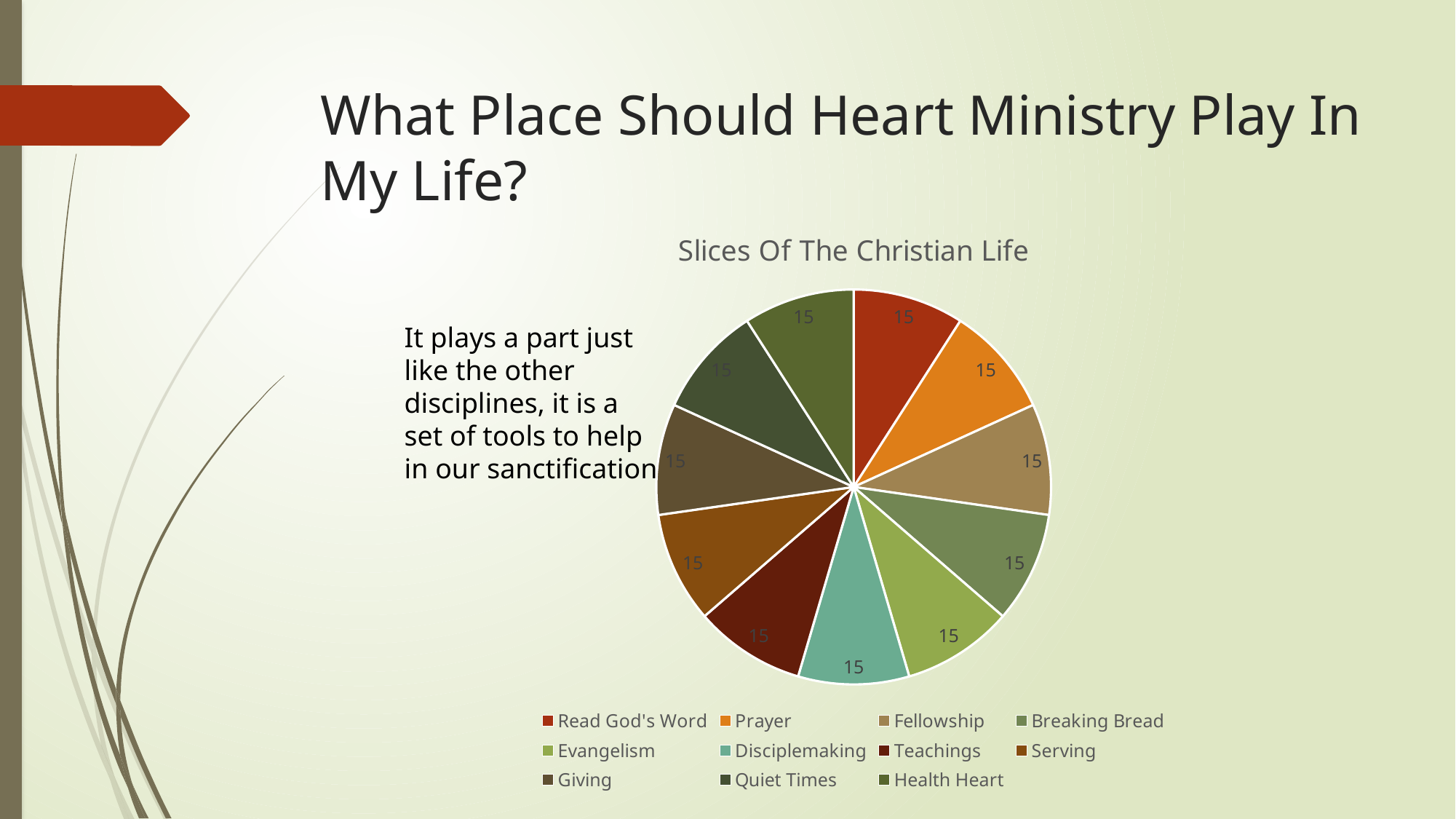
What is the difference between the values for Read God's Word and Giving? 0 How many entries does the chart legend list? 11 How many slices does the pie chart have? 11 What is the title of the chart? Slices Of The Christian Life What is the value shown for the Disciplemaking slice? 15 Is the value for the Teachings slice greater or less than 10? greater What type of chart is shown on the slide? pie chart What is the value shown for the Prayer slice? 15 What is the value shown for the Health Heart slice? 15 Which legend entry is shown in the red colour? Read God's Word Which is larger, the Fellowship slice or the Serving slice? They are equal What is the total of all the slice values in the pie chart? 165